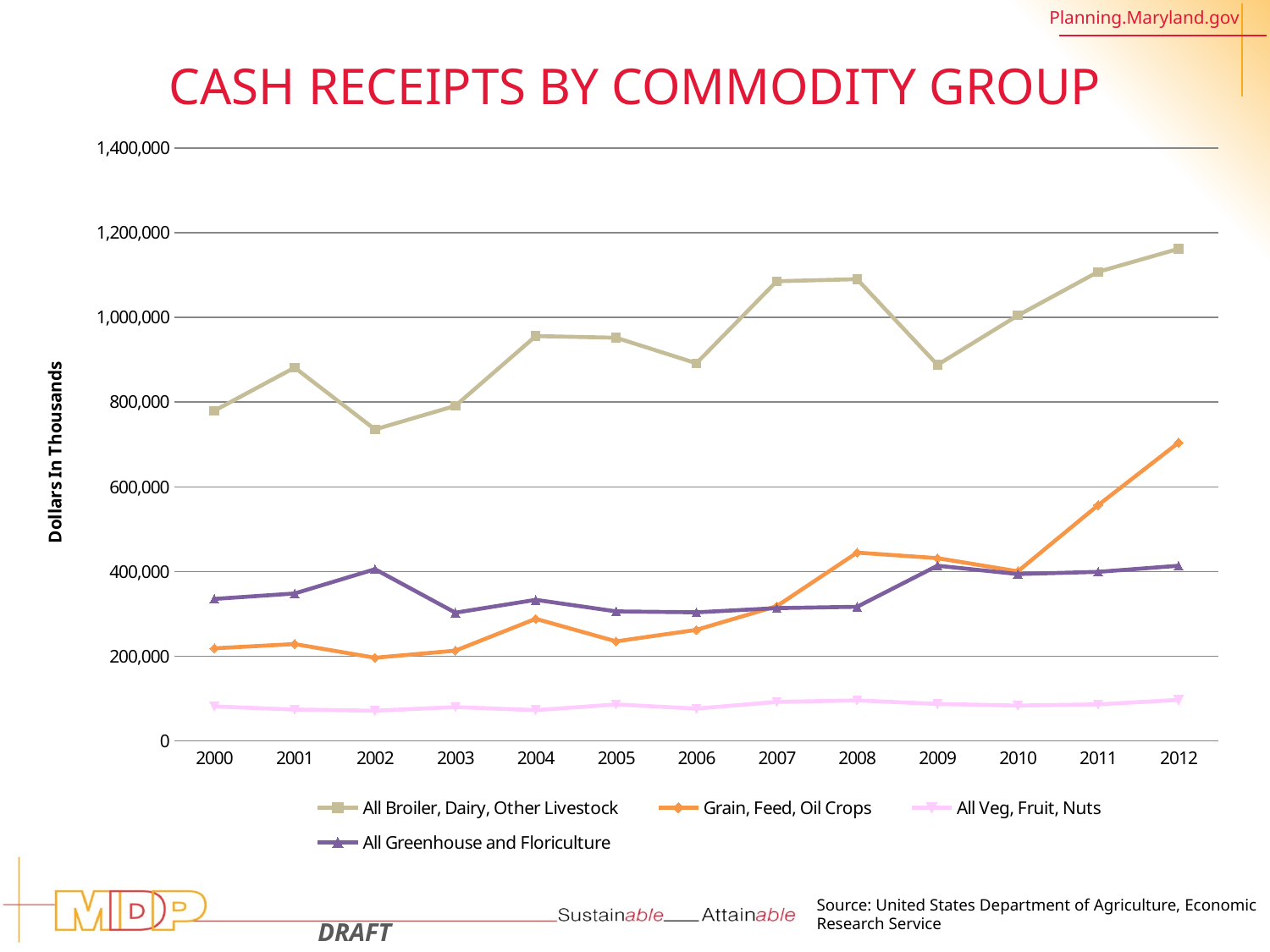
In which year is the value for All Broiler, Dairy, Other Livestock the lowest? 2002 In 2008, which is larger: Grain, Feed, Oil Crops or All Greenhouse and Floriculture? Grain, Feed, Oil Crops Is the value for Grain, Feed, Oil Crops in 2012 greater or less than 600,000? greater Is the value for All Broiler, Dairy, Other Livestock in 2012 greater or less than 1,000,000? greater What kind of chart is shown on the slide? line chart What is the title of the y axis? Dollars In Thousands Which commodity group has the lowest cash receipts in every year shown? All Veg, Fruit, Nuts Which commodity group has the highest cash receipts in 2012? All Broiler, Dairy, Other Livestock Is the value for All Greenhouse and Floriculture in 2003 greater or less than 400,000? less How many years are shown along the x axis? 13 Do the values for Grain, Feed, Oil Crops rise or fall from 2009 to 2012? rise How many series does the legend list? 4